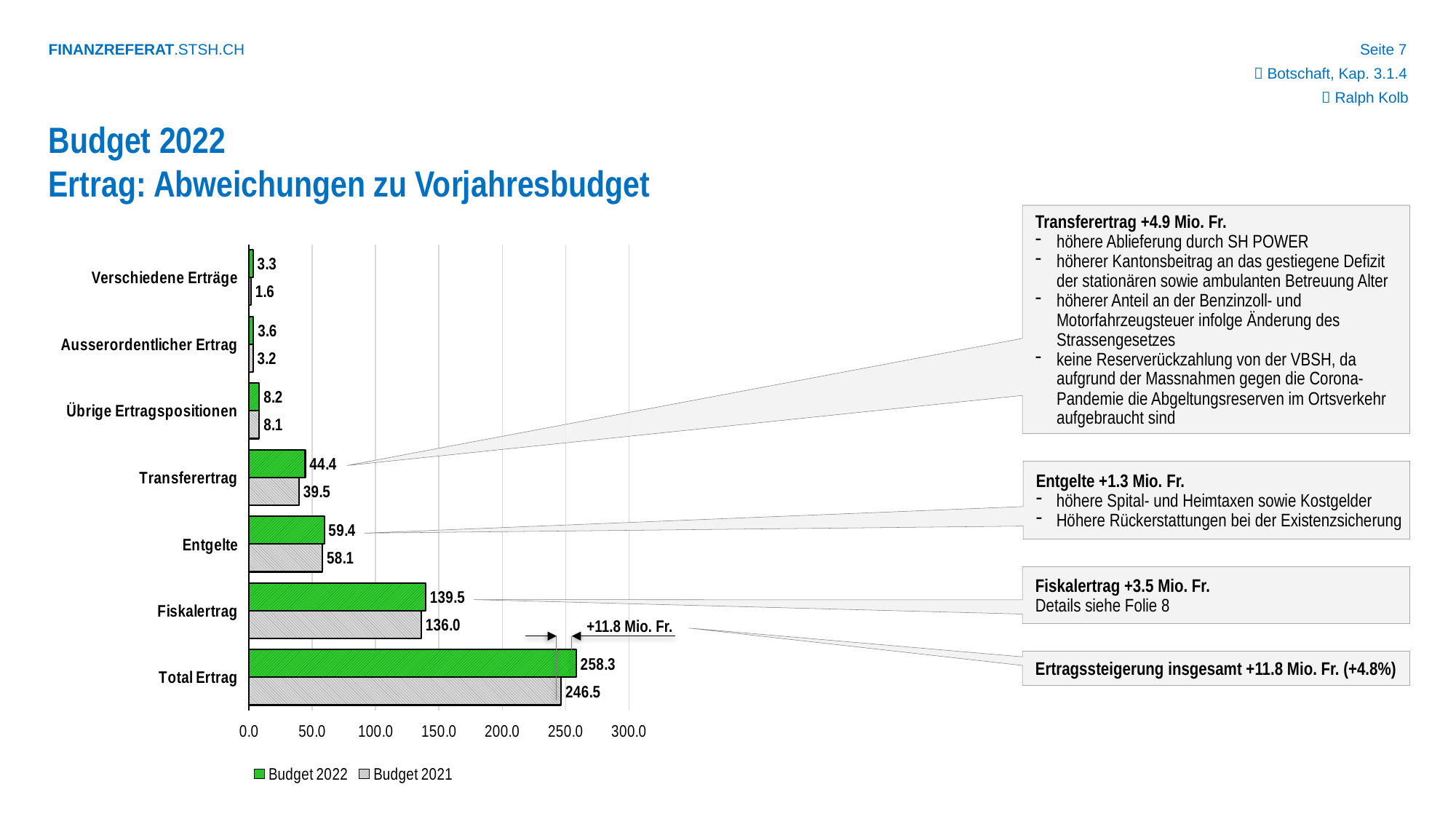
What is the difference between the Budget 2022 and Budget 2021 values for Entgelte? 1.3 What kind of chart is shown on the slide? Bar chart What is the Budget 2021 value for Verschiedene Erträge? 1.6 How many categories are shown on the y axis of the chart? 7 Which category has the highest Budget 2021 value? Total Ertrag How many series does the legend list? 2 What is the Budget 2021 value for Transferertrag? 39.5 Which category has the lowest Budget 2022 value? Verschiedene Erträge What is the Budget 2022 value for Fiskalertrag? 139.5 What is the Budget 2022 value for Total Ertrag? 258.3 What is the difference between the Budget 2022 and Budget 2021 values for Total Ertrag? 11.8 Which is larger: the Budget 2022 value for Transferertrag or the Budget 2021 value for Entgelte? Budget 2021 value for Entgelte